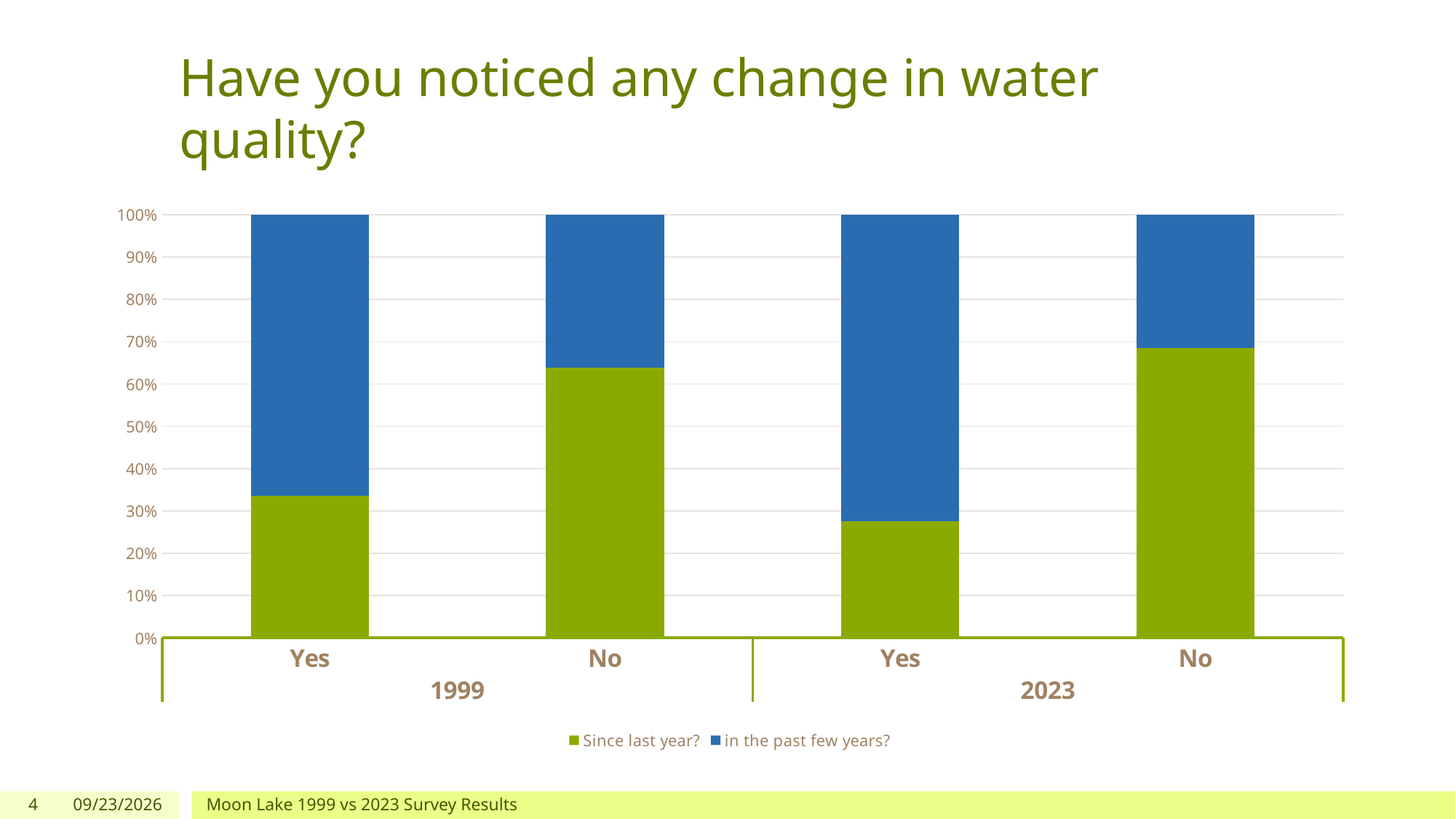
What kind of chart is shown on the slide? Stacked bar chart How many series does the legend list? 2 Is the 'Since last year?' value for No in 1999 greater or less than 60%? greater Which bar has the smallest 'Since last year?' share? Yes (2023) What is the total height of each stacked bar? 100% Is the 'Since last year?' value for Yes in 2023 greater or less than 40%? less Which bar has the largest 'Since last year?' share? No (2023) Which colour represents the 'in the past few years?' series? Blue How many bars are plotted in the chart? 4 Is the 'Since last year?' value for No in 2023 greater or less than 60%? greater In 1999, which has the larger 'in the past few years?' share, Yes or No? Yes